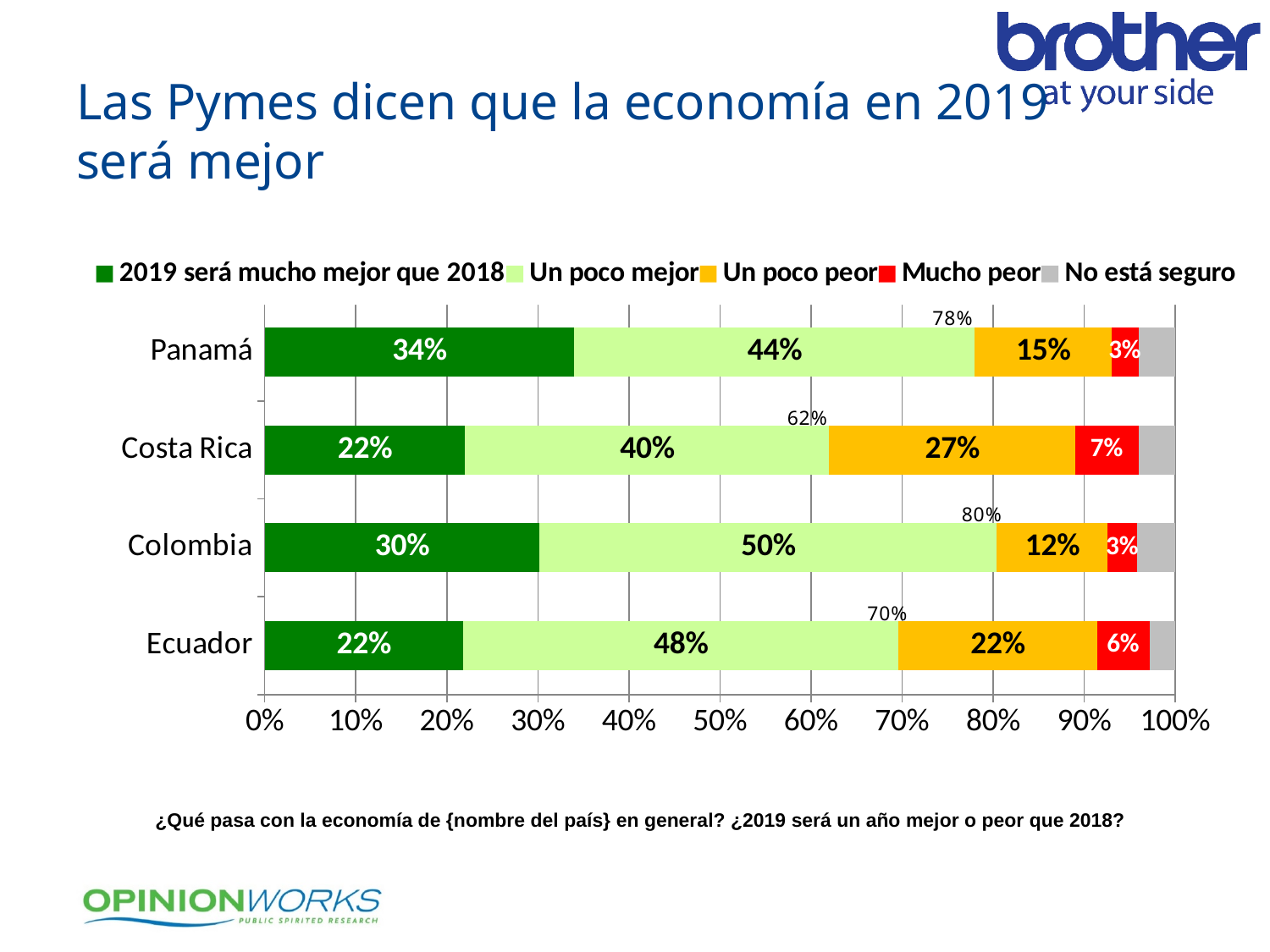
Which country has the highest share saying '2019 será mucho mejor que 2018'? Panamá What is the combined share of the two 'mejor' responses for Colombia, as labelled above its bar? 80% What percentage of Pymes in Panamá say 2019 será mucho mejor que 2018? 34% What is the 'Un poco peor' value for Costa Rica? 27% What is the 'Un poco mejor' value for Colombia? 50% What kind of chart is shown on the slide? Stacked bar chart What is the 'Mucho peor' value for Ecuador? 6% How many countries are shown in the chart? 4 Which country has the larger 'Un poco peor' value, Colombia or Ecuador? Ecuador What is the difference in percentage points between Panamá and Costa Rica for '2019 será mucho mejor que 2018'? 12 percentage points How many series does the legend list? 5 Which country has the lowest 'Un poco mejor' value? Costa Rica